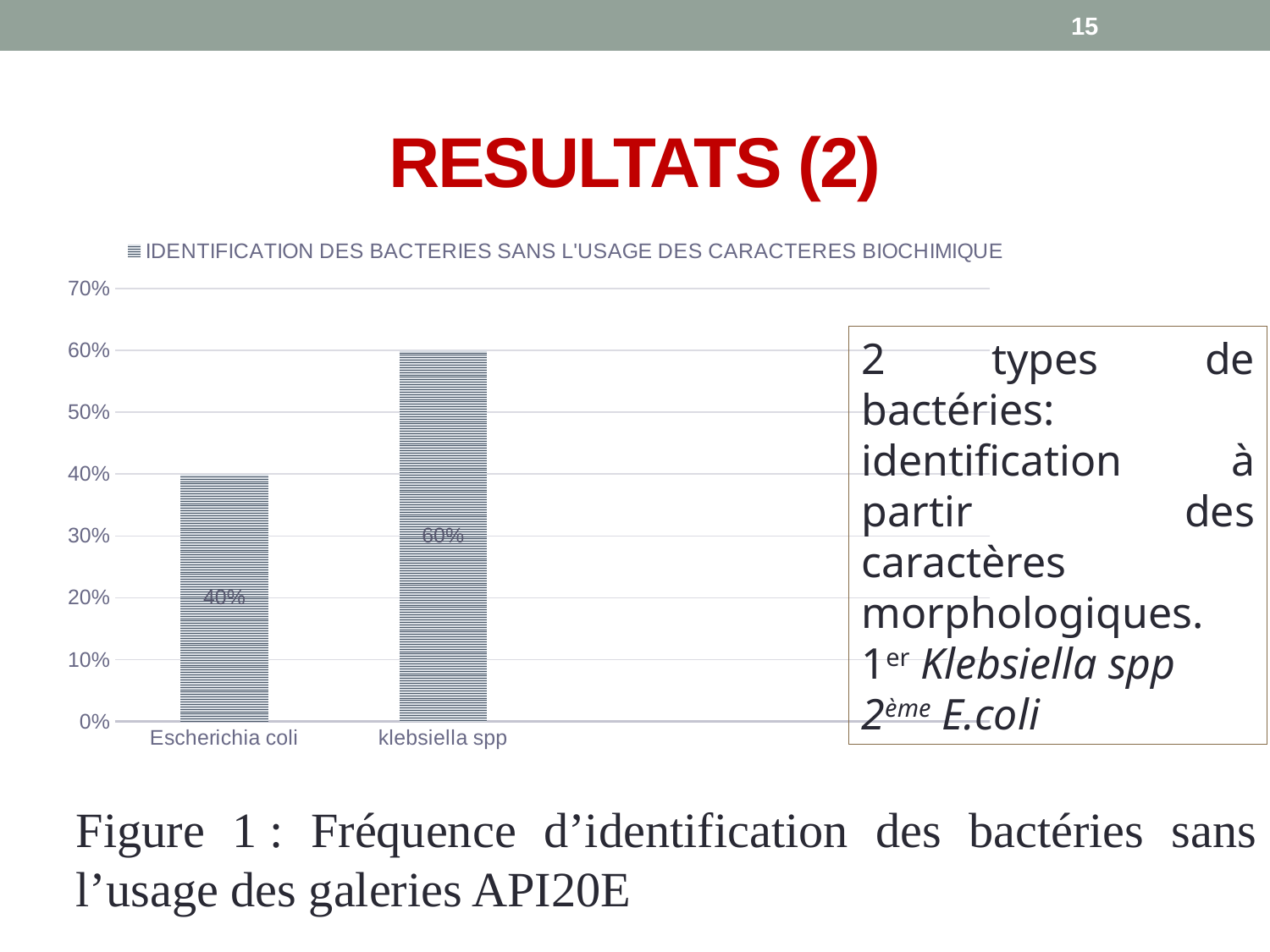
What is the value for Escherichia coli? 40% Which category has the lowest value? Escherichia coli Is the value for Escherichia coli greater or less than 50%? less How many series does the legend list? 1 Is the value for klebsiella spp greater or less than 50%? greater How many categories are shown on the x axis? 2 What is the difference between the values for klebsiella spp and Escherichia coli? 20% What kind of chart is shown? bar chart Which is larger, the value for Escherichia coli or the value for klebsiella spp? klebsiella spp What is the value for klebsiella spp? 60% Which category has the highest value? klebsiella spp What is the legend entry of the series shown in the chart? IDENTIFICATION DES BACTERIES SANS L'USAGE DES CARACTERES BIOCHIMIQUE